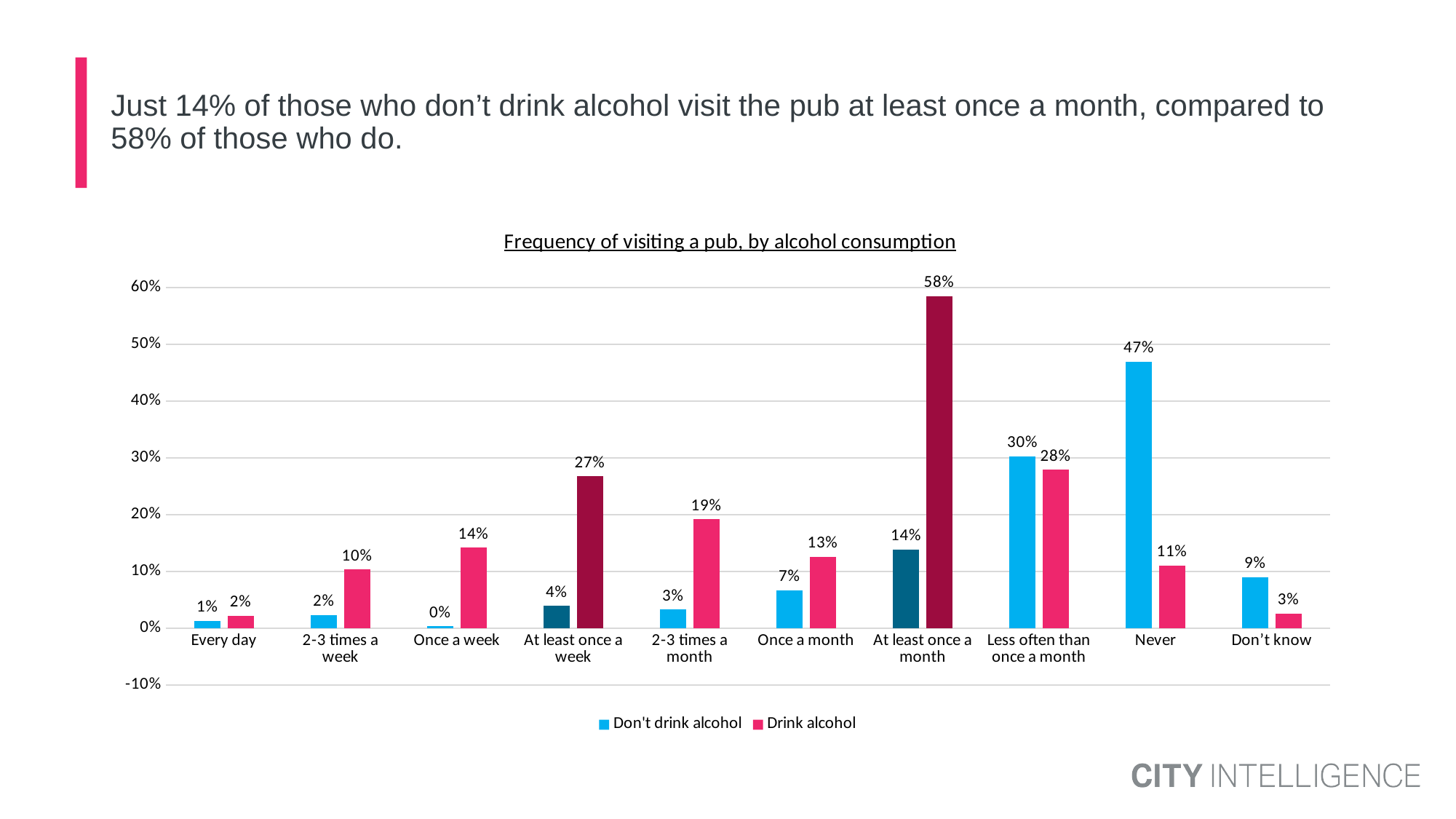
What is the value for 'Once a week' among those who don't drink alcohol? 0% What percentage of those who drink alcohol visit the pub at least once a month? 58% What percentage of those who don't drink alcohol never visit the pub? 47% For 'Less often than once a month', which series has the larger value? Don't drink alcohol What is the title of the chart? Frequency of visiting a pub, by alcohol consumption How many categories are shown on the x axis? 10 What kind of chart is shown on the slide? Bar chart Which category has the highest value for the 'Drink alcohol' series? At least once a month How many series does the legend list? 2 What is the difference between the 'Drink alcohol' and 'Don't drink alcohol' values for 'At least once a month'? 44 percentage points Which category has the lowest value for the 'Don't drink alcohol' series? Once a week Is the 'Drink alcohol' value for 'At least once a week' greater or less than 20%? greater